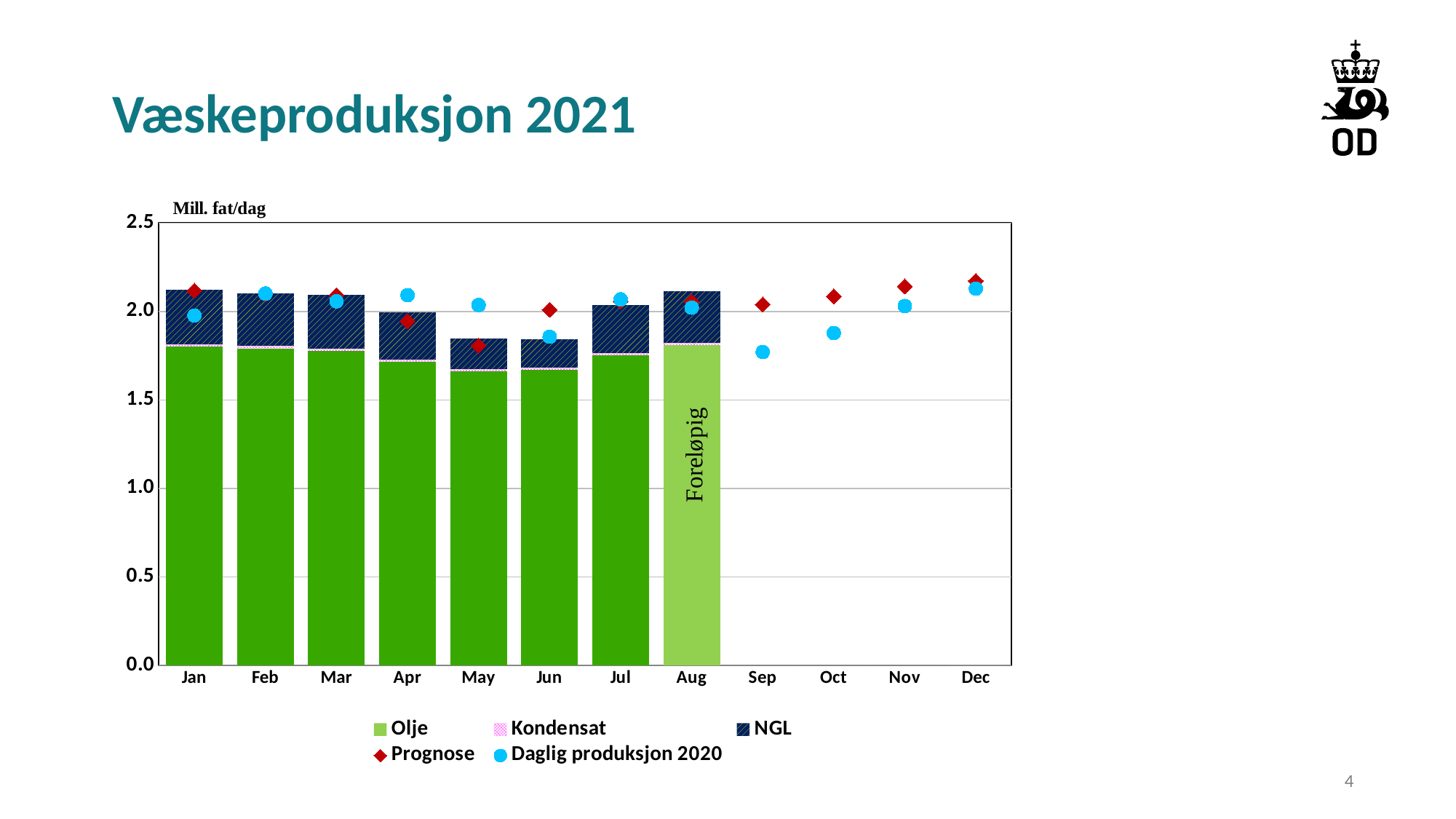
Is the Daglig produksjon 2020 value for Sep greater or less than 2.0? less How many months have a stacked bar plotted? 8 Do the Daglig produksjon 2020 values rise or fall from Sep to Dec? rise What kind of chart is shown on the slide? combination chart (stacked bars with point markers) How many months are shown on the x axis? 12 Is the Prognose value for Dec greater or less than 2.0? greater Is the total stacked bar for May greater or less than 2.0? less Which is larger, the total stacked bar for Jan or for Jun? Jan How many series does the legend list? 5 What unit is shown on the y axis of the chart? Mill. fat/dag What is the title of the chart? Væskeproduksjon 2021